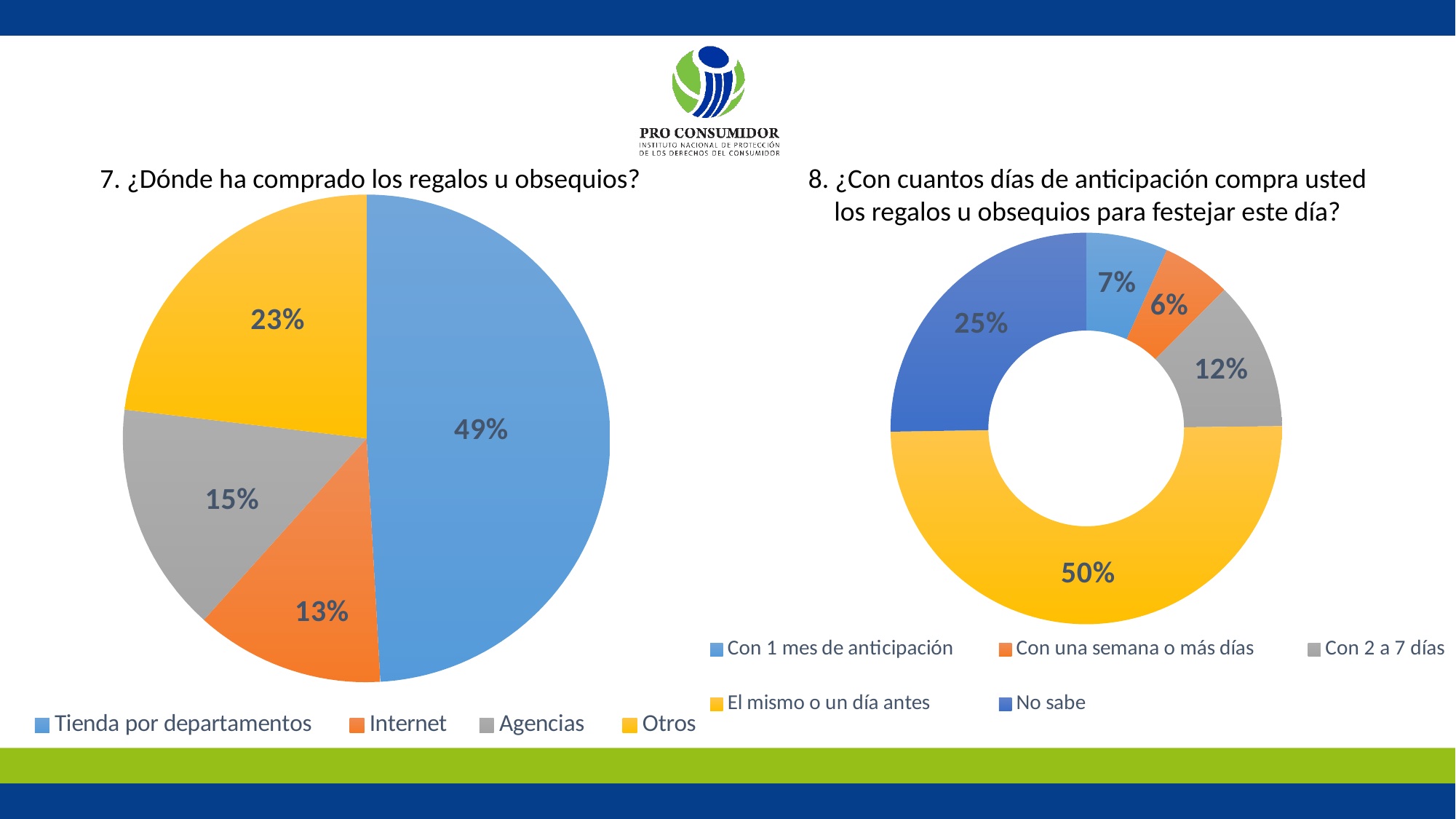
In the left chart '7. ¿Dónde ha comprado los regalos u obsequios?', what is the difference in percentage points between Otros and Agencias? 8 In the right chart '8. ¿Con cuantos días de anticipación compra usted los regalos u obsequios para festejar este día?', which category has the smallest share? Con una semana o más días In the left chart '7. ¿Dónde ha comprado los regalos u obsequios?', how many categories does the legend list? 4 In the right chart '8. ¿Con cuantos días de anticipación compra usted los regalos u obsequios para festejar este día?', which is larger: No sabe or Con 1 mes de anticipación? No sabe What kind of chart is the left chart '7. ¿Dónde ha comprado los regalos u obsequios?'? Pie chart In the left chart '7. ¿Dónde ha comprado los regalos u obsequios?', which category has the largest share? Tienda por departamentos In the right chart '8. ¿Con cuantos días de anticipación compra usted los regalos u obsequios para festejar este día?', what percentage is shown for Con 2 a 7 días? 12% In the left chart '7. ¿Dónde ha comprado los regalos u obsequios?', what percentage is shown for Tienda por departamentos? 49% In the right chart '8. ¿Con cuantos días de anticipación compra usted los regalos u obsequios para festejar este día?', how many categories does the legend list? 5 In the left chart '7. ¿Dónde ha comprado los regalos u obsequios?', what percentage is shown for Internet? 13% In the right chart '8. ¿Con cuantos días de anticipación compra usted los regalos u obsequios para festejar este día?', what percentage is shown for El mismo o un día antes? 50% In the left chart '7. ¿Dónde ha comprado los regalos u obsequios?', which category has the smallest share? Internet